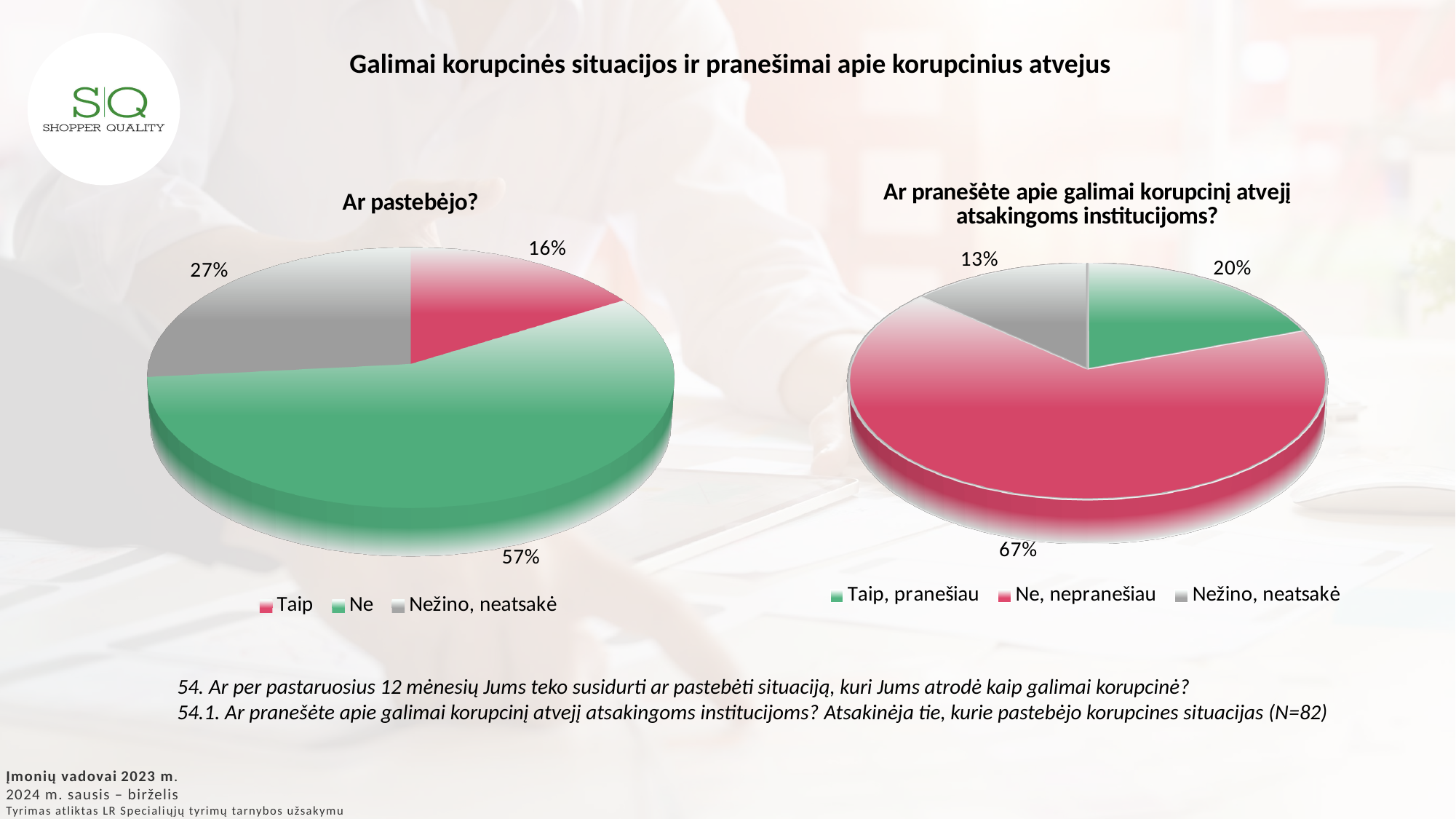
In the "Ar pastebėjo?" chart, what share is labelled for "Nežino, neatsakė"? 27% How many categories does the legend of the "Ar pastebėjo?" chart list? 3 In the "Ar pastebėjo?" chart, which category has the largest slice? Ne In the "Ar pastebėjo?" chart, which category has the smallest slice? Taip In the "Ar pranešėte apie galimai korupcinį atvejį atsakingoms institucijoms?" chart, what share is labelled for "Ne, nepranešiau"? 67% In the "Ar pastebėjo?" chart, what share is labelled for "Taip"? 16% In the "Ar pranešėte apie galimai korupcinį atvejį atsakingoms institucijoms?" chart, what share is labelled for "Taip, pranešiau"? 20% In the "Ar pranešėte apie galimai korupcinį atvejį atsakingoms institucijoms?" chart, which is larger: "Taip, pranešiau" or "Nežino, neatsakė"? Taip, pranešiau In the "Ar pastebėjo?" chart, what share is labelled for "Ne"? 57% What type of chart is the "Ar pastebėjo?" chart? Pie chart In the "Ar pastebėjo?" chart, what is the difference between the "Ne" and "Taip" shares? 41 percentage points In the "Ar pranešėte apie galimai korupcinį atvejį atsakingoms institucijoms?" chart, which category has the smallest slice? Nežino, neatsakė